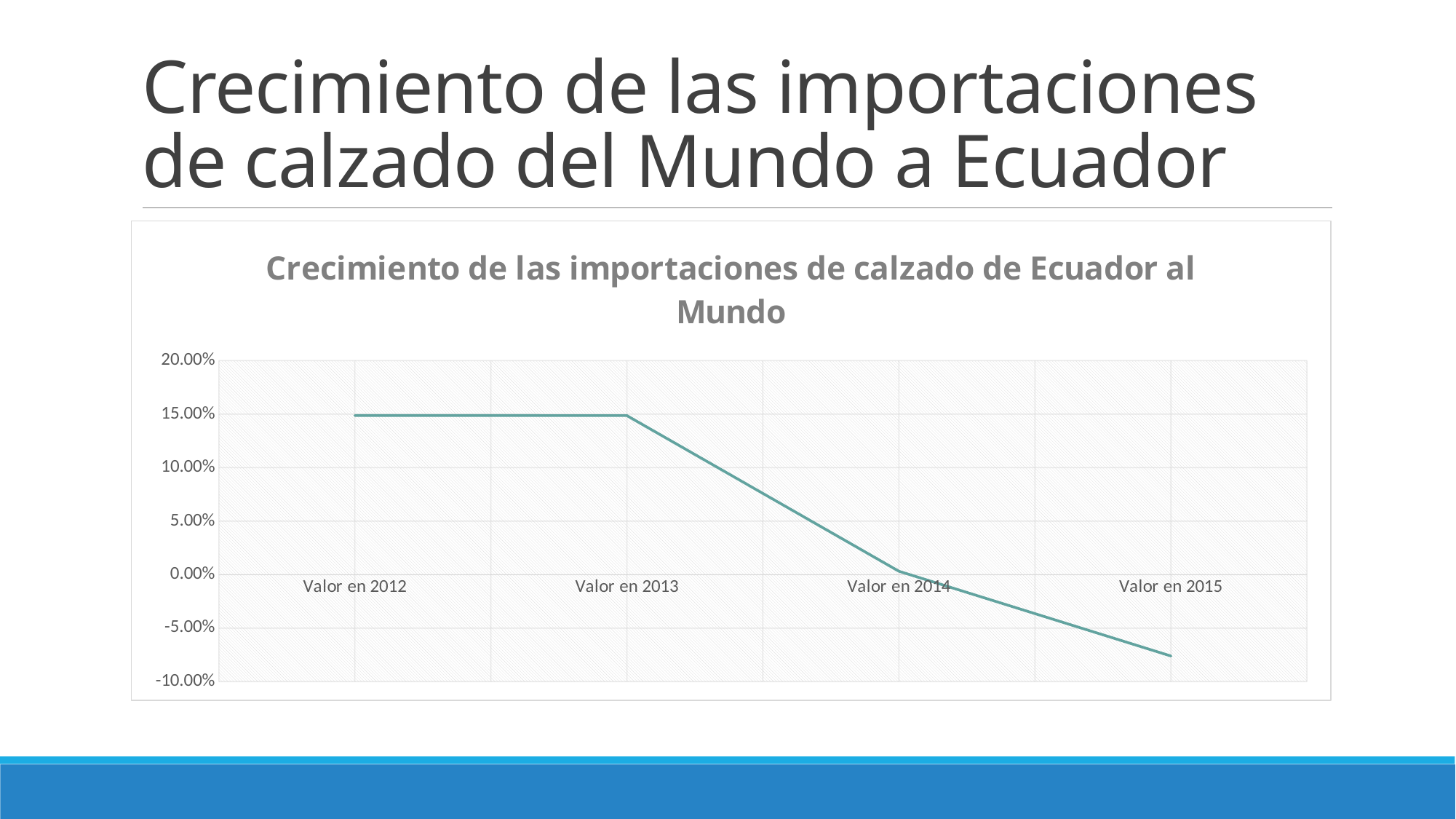
Is the value for Valor en 2014 greater or less than 5.00%? less Is the value for Valor en 2012 greater or less than 10.00%? greater Is the value for Valor en 2015 greater or less than -5.00%? less Which category has the lowest value on the chart? Valor en 2015 What is the title of the chart? Crecimiento de las importaciones de calzado de Ecuador al Mundo Do the values rise or fall from Valor en 2013 to Valor en 2015? fall How many data points are plotted on the chart? 4 What kind of chart is shown on the slide? line chart Which is larger, the value for Valor en 2013 or the value for Valor en 2014? Valor en 2013 Which is larger, the value for Valor en 2014 or the value for Valor en 2015? Valor en 2014